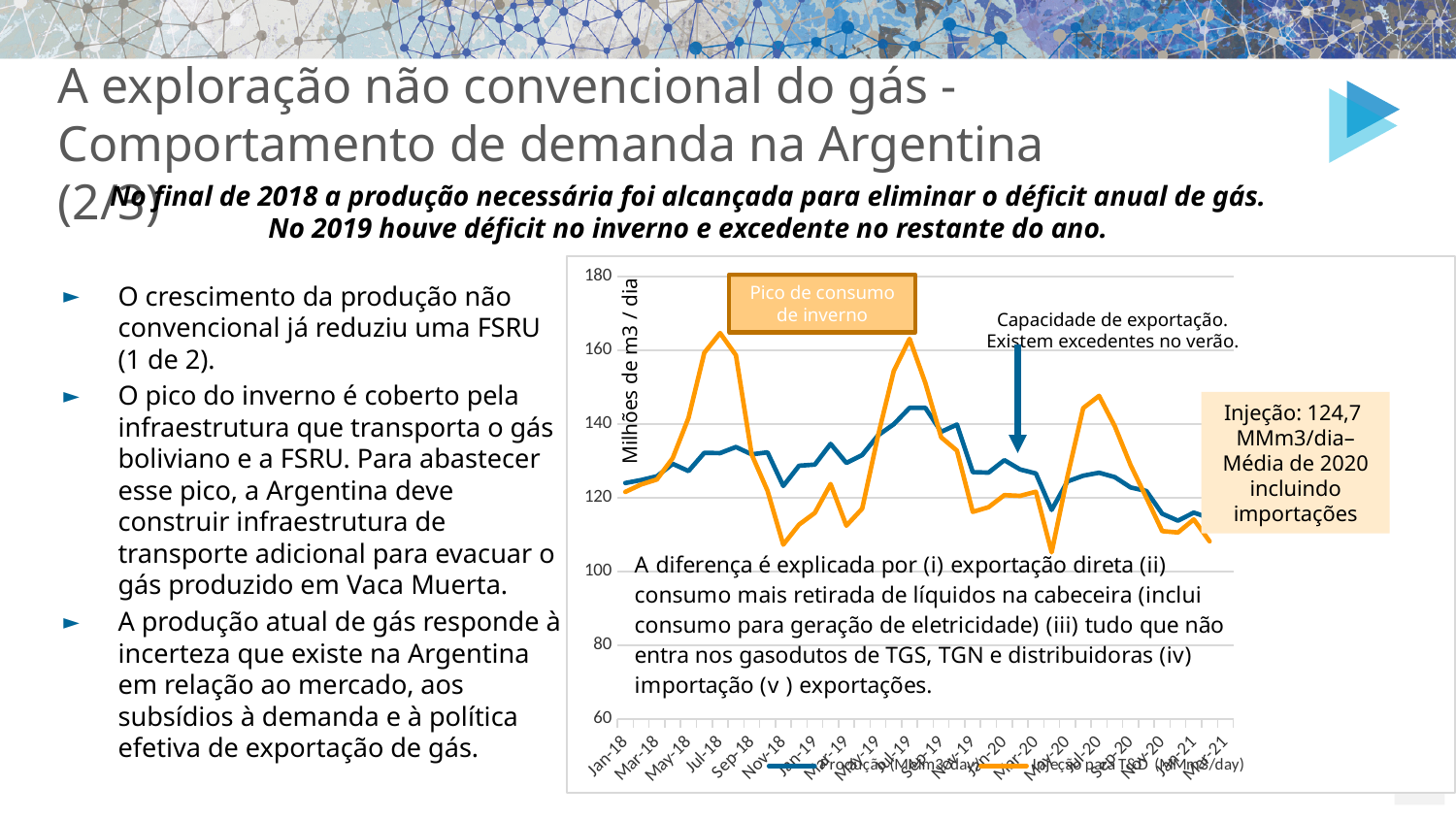
What is the label of the vertical axis of the chart? Milhões de m3 / dia Which series reaches the highest value on the chart? Injeção para T&D (MMm3/day) Does the Produção series generally rise or fall from Jan-18 to Jul-19? rise Is the value of Produção at Jan-18 greater or less than 140? less What is the highest tick value shown on the vertical axis of the chart? 180 Does the Produção series generally rise or fall from Jul-19 to Mar-21? fall How many series does the chart's legend list? 2 What kind of chart is shown on the slide? Line chart